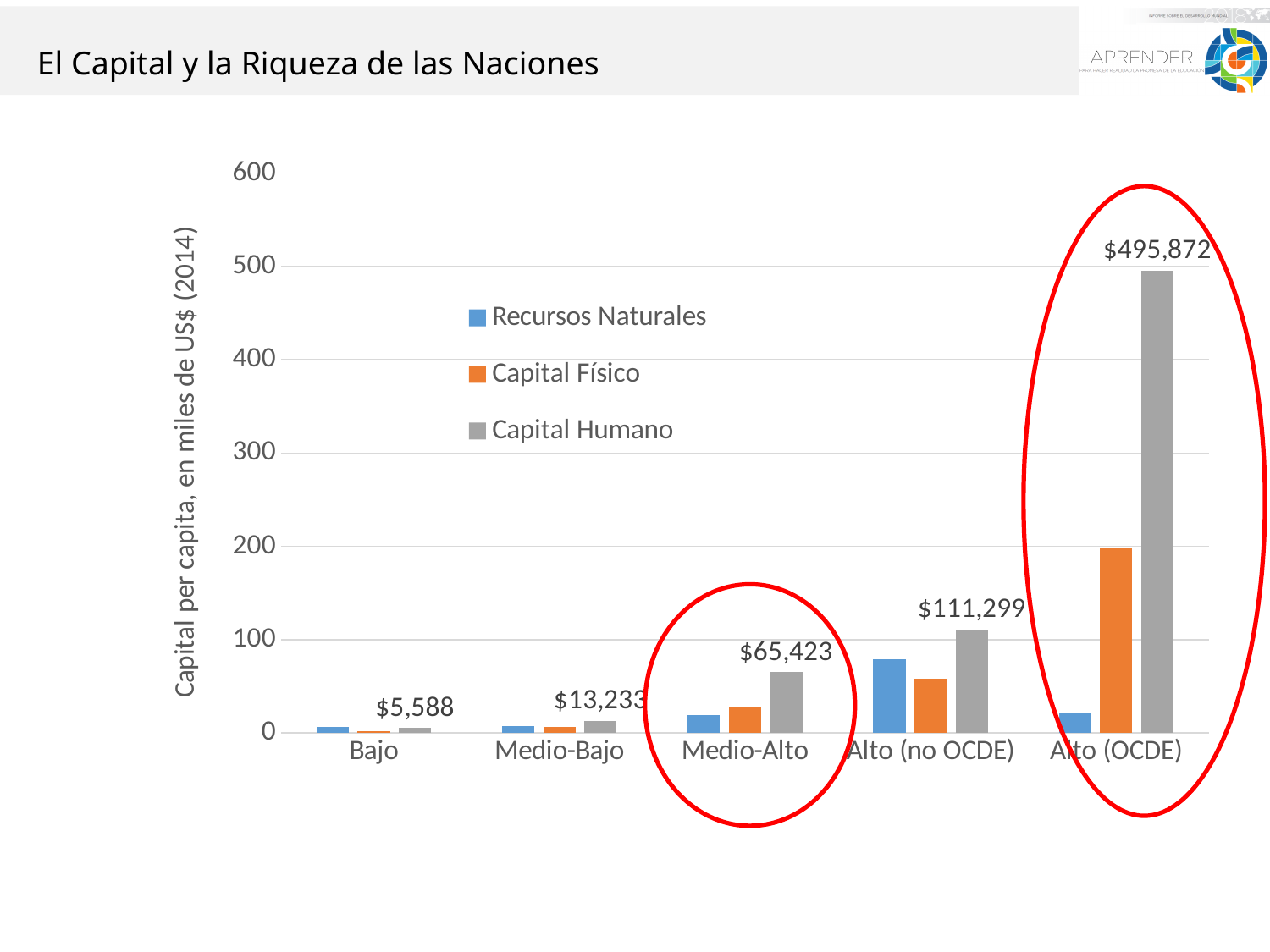
What is the difference between the Capital Humano values for Alto (OCDE) and Alto (no OCDE)? $384,573 What is the Capital Humano value for Medio-Alto? $65,423 Which category has the highest Capital Humano value? Alto (OCDE) Which has a larger Capital Humano value, Medio-Alto or Alto (no OCDE)? Alto (no OCDE) Is the Capital Físico value for Alto (OCDE) greater or less than 100? greater Which category has the lowest Capital Humano value? Bajo How many series does the legend list? 3 What kind of chart is shown on the slide? bar chart How many income categories are shown on the x axis? 5 What is the Capital Humano value for Alto (OCDE)? $495,872 Do the Capital Humano values rise or fall from Bajo to Alto (OCDE)? rise What is the Capital Humano value for Bajo? $5,588